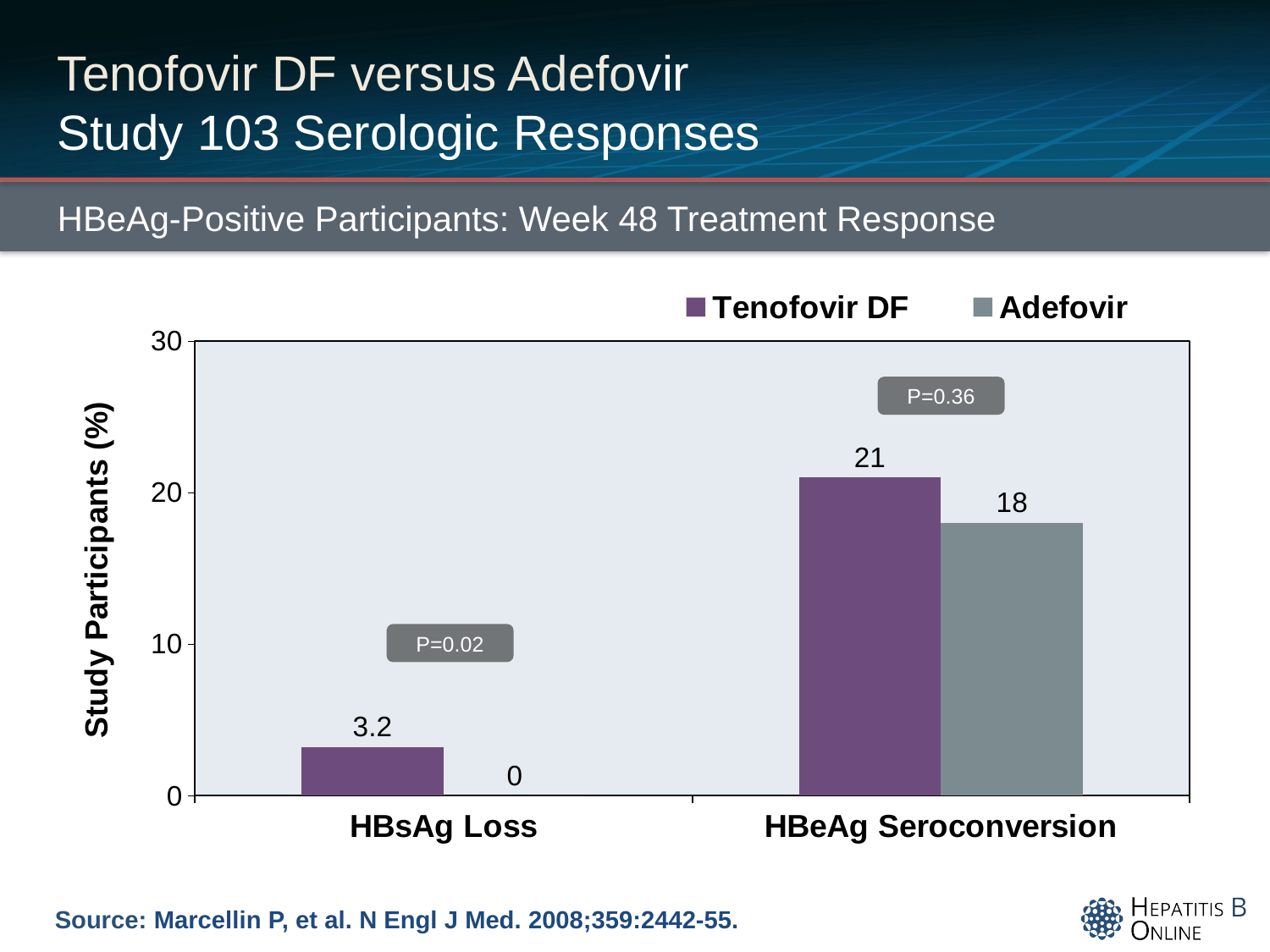
What kind of chart is shown on the slide? Bar chart How many series does the legend list? 2 Which category has the highest value for Tenofovir DF? HBeAg Seroconversion What is the value for Tenofovir DF in the HBeAg Seroconversion category? 21 Is the Tenofovir DF value for HBeAg Seroconversion greater or less than 20? greater Which series has the higher value for HBeAg Seroconversion? Tenofovir DF What is the difference between the Tenofovir DF and Adefovir values for HBsAg Loss? 3.2 What is the value for Adefovir in the HBeAg Seroconversion category? 18 What is the P value shown for the HBsAg Loss comparison? P=0.02 What is the value for Tenofovir DF in the HBsAg Loss category? 3.2 What is the difference between the Tenofovir DF and Adefovir values for HBeAg Seroconversion? 3 What is the value for Adefovir in the HBsAg Loss category? 0